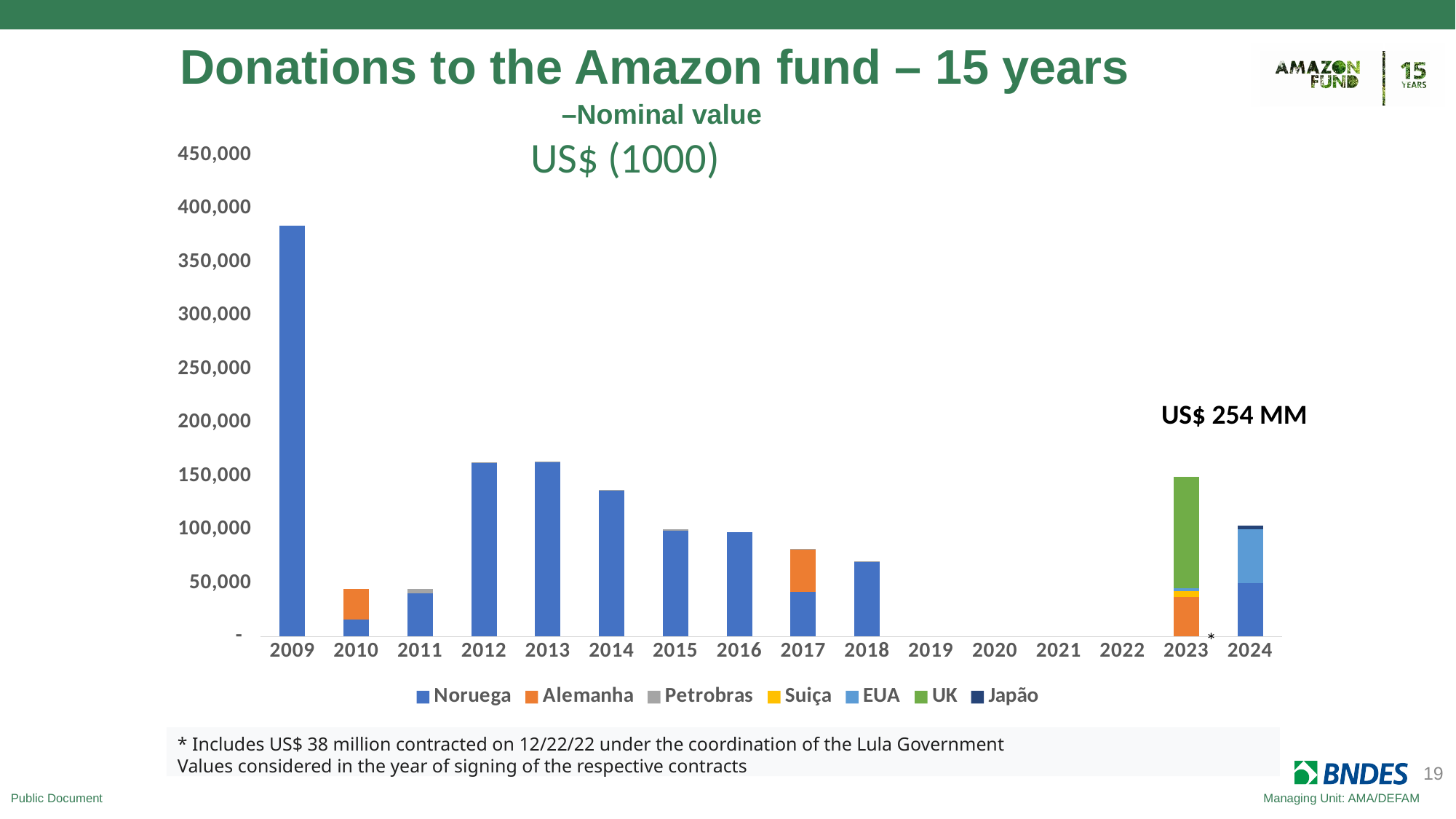
What kind of chart is shown on the slide? Bar chart Which is larger, the total for 2014 or the total for 2018? 2014 How many years are shown on the x axis? 16 How many series does the legend list? 7 What annotation is printed above the 2023 and 2024 bars? US$ 254 MM Which is larger, the total for 2023 or the total for 2024? 2023 Is the value for 2018 greater or less than 50,000? greater From 2013 to 2018, do the yearly totals rise or fall? fall Is the value for 2014 greater or less than 150,000? less Which donor contributes the largest portion of the 2023 bar? UK Is the value for 2009 greater or less than 350,000? greater Which year has the highest total donation? 2009